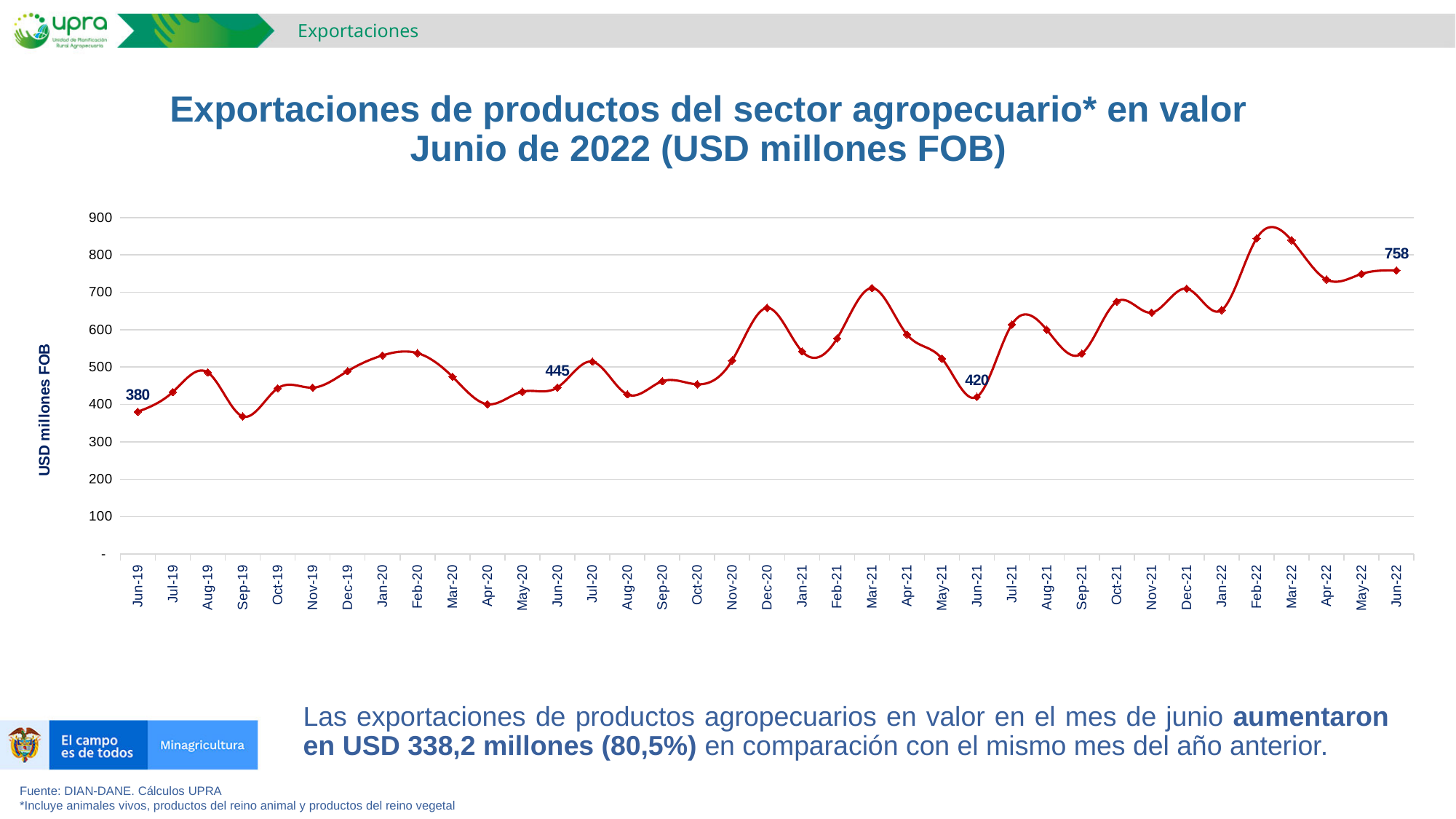
What is the value for Jun-19? 380 What is the value for Jun-21? 420 Overall, do the values rise or fall from Jun-19 to Jun-22? rise Is the value for Dec-20 greater or less than 600? greater What kind of chart is shown on the slide? line chart What is the value for Jun-22? 758 What is the value for Jun-20? 445 Is the value for Feb-22 greater or less than 800? greater What is the difference between the values for Jun-20 and Jun-19? 65 Is the value for Sep-19 greater or less than 400? less Which is larger, the value for Jun-20 or the value for Jun-21? Jun-20 What is the difference between the values for Jun-22 and Jun-21? 338